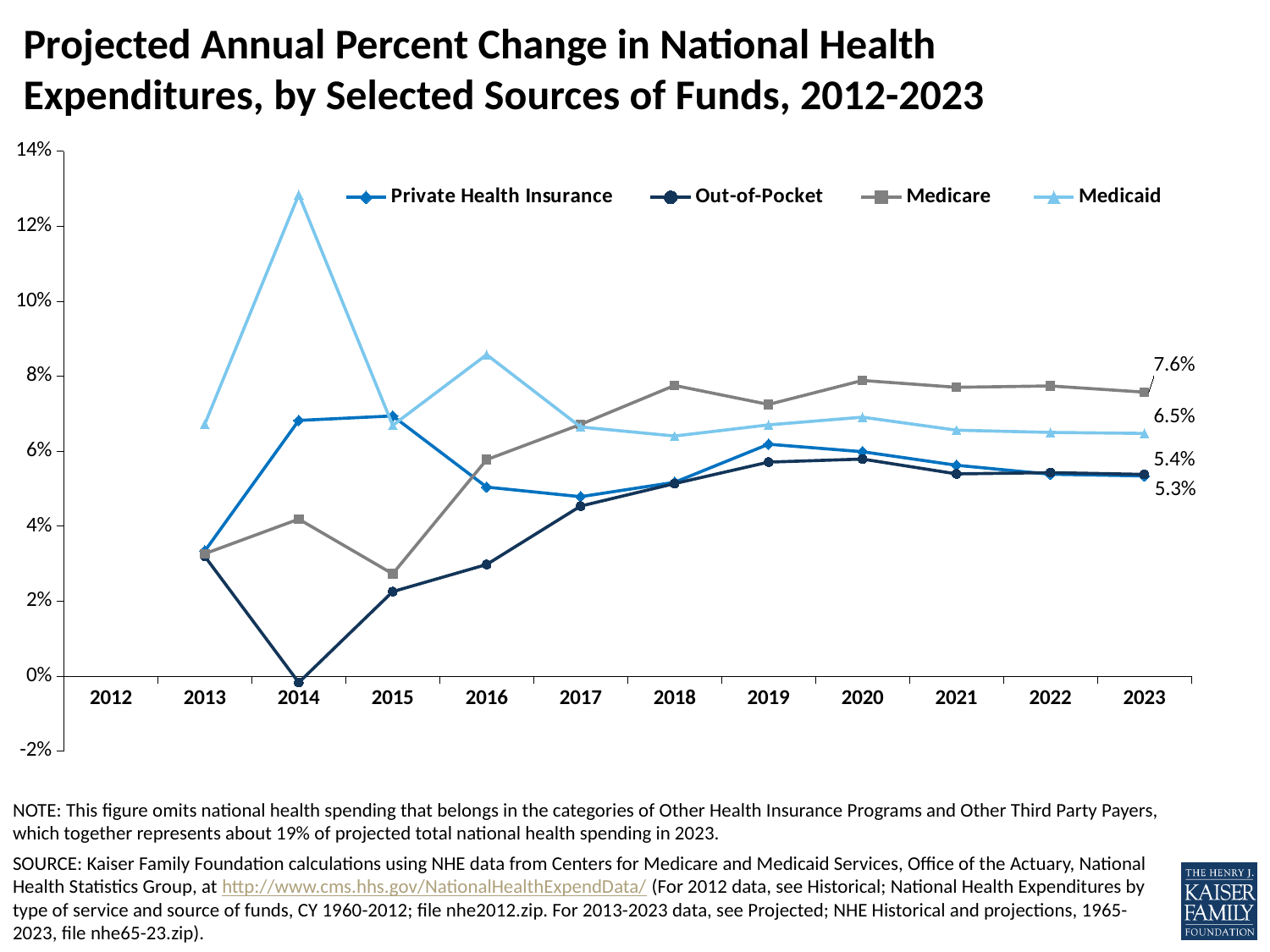
What is the projected annual percent change for Medicare in 2023? 7.6% What is the difference between the Medicare and Medicaid values in 2023? 1.1% Is the value for Medicaid in 2014 greater or less than 12%? greater In which year does the Medicaid series reach its highest value? 2014 How many series does the legend list? 4 In 2016, which is larger: the Medicaid value or the Medicare value? Medicaid Which series has the highest value in 2023? Medicare What kind of chart is shown on the slide? line chart Is the value for Medicare in 2015 greater or less than 4%? less Which series has the lowest value in 2014? Out-of-Pocket How many years are labeled on the x axis? 12 What is the projected annual percent change for Medicaid in 2023? 6.5%